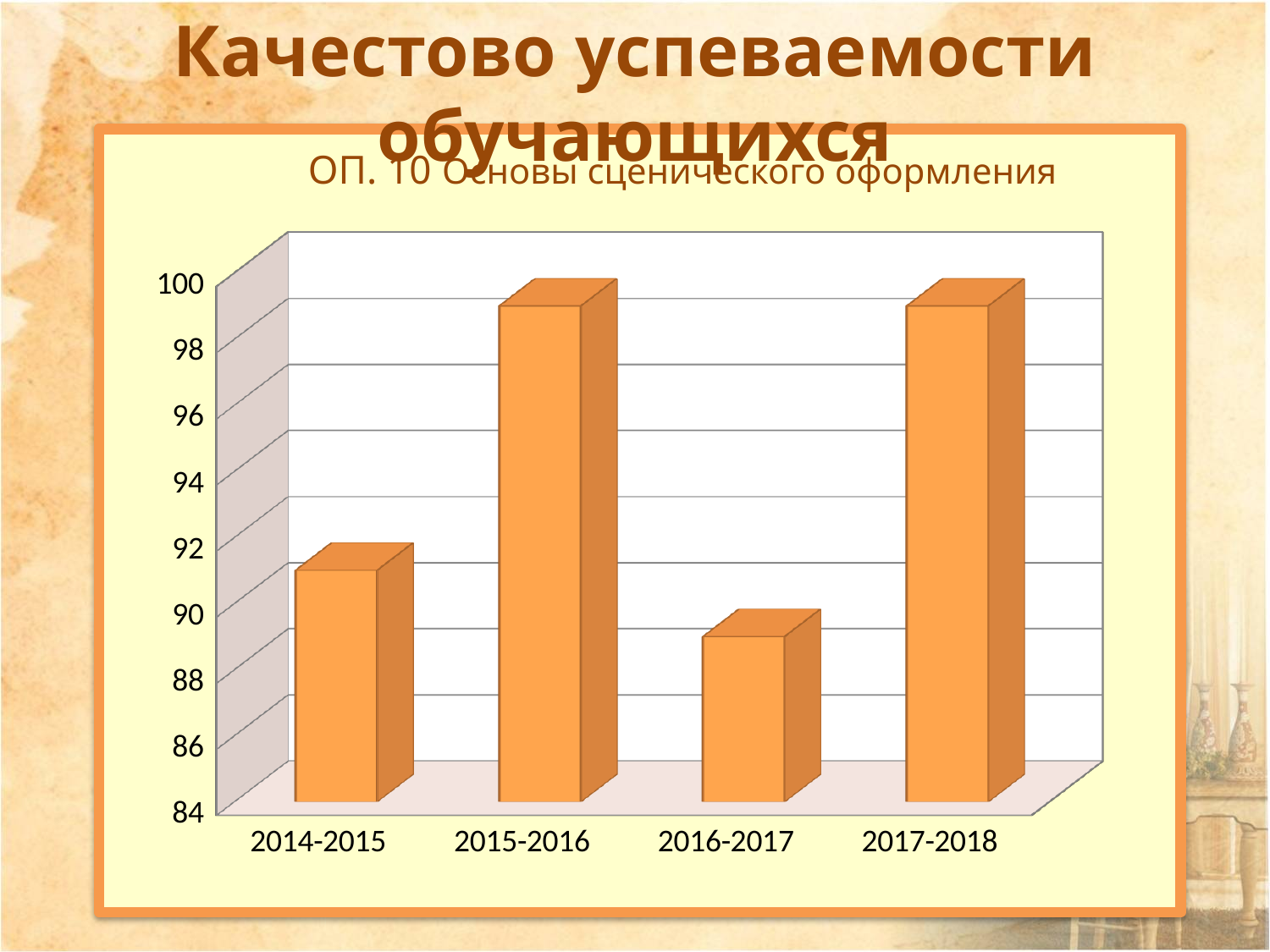
Is the value for 2016-2017 greater or less than 90? less Does the value rise or fall from 2015-2016 to 2016-2017? fall Is the value for 2017-2018 greater or less than 96? greater Which academic year has the lowest value in the chart? 2016-2017 What is the title of the chart? ОП. 10 Основы сценического оформления Which is larger, the value for 2015-2016 or the value for 2014-2015? 2015-2016 Is the value for 2014-2015 greater or less than 90? greater What kind of chart is shown on the slide? bar chart How many academic years are shown on the x axis of the chart? 4 Which is larger, the value for 2014-2015 or the value for 2016-2017? 2014-2015